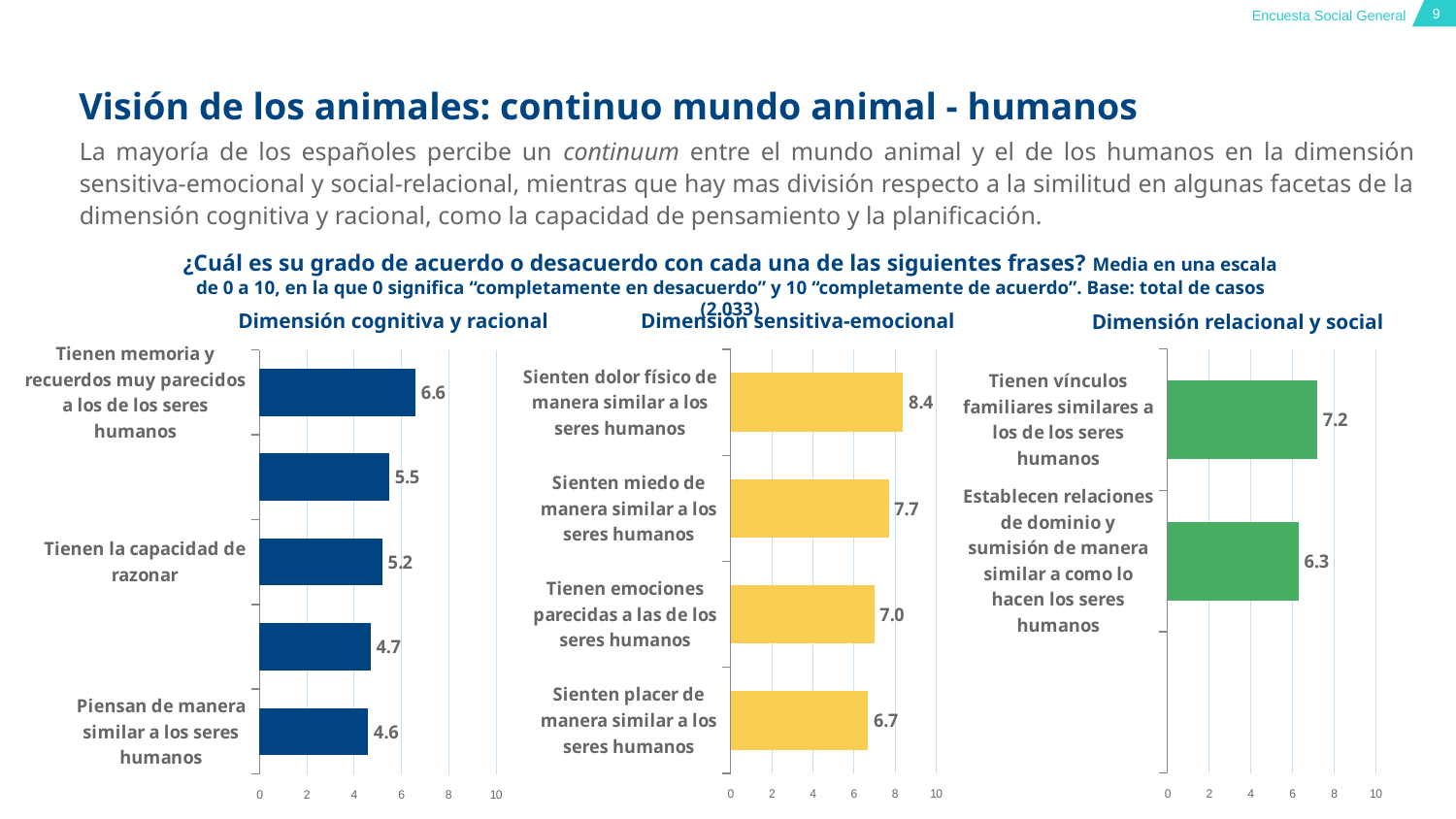
In the 'Dimensión relacional y social' chart, what is the value for 'Tienen vínculos familiares similares a los de los seres humanos'? 7.2 In the 'Dimensión cognitiva y racional' chart, how many bars are plotted? 5 In the 'Dimensión sensitiva-emocional' chart, what is the difference between 'Sienten dolor físico de manera similar a los seres humanos' and 'Tienen emociones parecidas a las de los seres humanos'? 1.4 In the 'Dimensión relacional y social' chart, which is larger: 'Tienen vínculos familiares similares a los de los seres humanos' or 'Establecen relaciones de dominio y sumisión de manera similar a como lo hacen los seres humanos'? Tienen vínculos familiares similares a los de los seres humanos In the 'Dimensión cognitiva y racional' chart, what is the value for 'Tienen la capacidad de razonar'? 5.2 In the 'Dimensión sensitiva-emocional' chart, how many categories are shown? 4 In the 'Dimensión sensitiva-emocional' chart, which category has the lowest value? Sienten placer de manera similar a los seres humanos What type of chart is the 'Dimensión relacional y social' chart? Bar chart In the 'Dimensión cognitiva y racional' chart, which category has the highest value? Tienen memoria y recuerdos muy parecidos a los de los seres humanos In the 'Dimensión sensitiva-emocional' chart, what is the value for 'Sienten miedo de manera similar a los seres humanos'? 7.7 In the 'Dimensión cognitiva y racional' chart, what is the value for 'Piensan de manera similar a los seres humanos'? 4.6 What colour are the bars in the 'Dimensión sensitiva-emocional' chart? Yellow